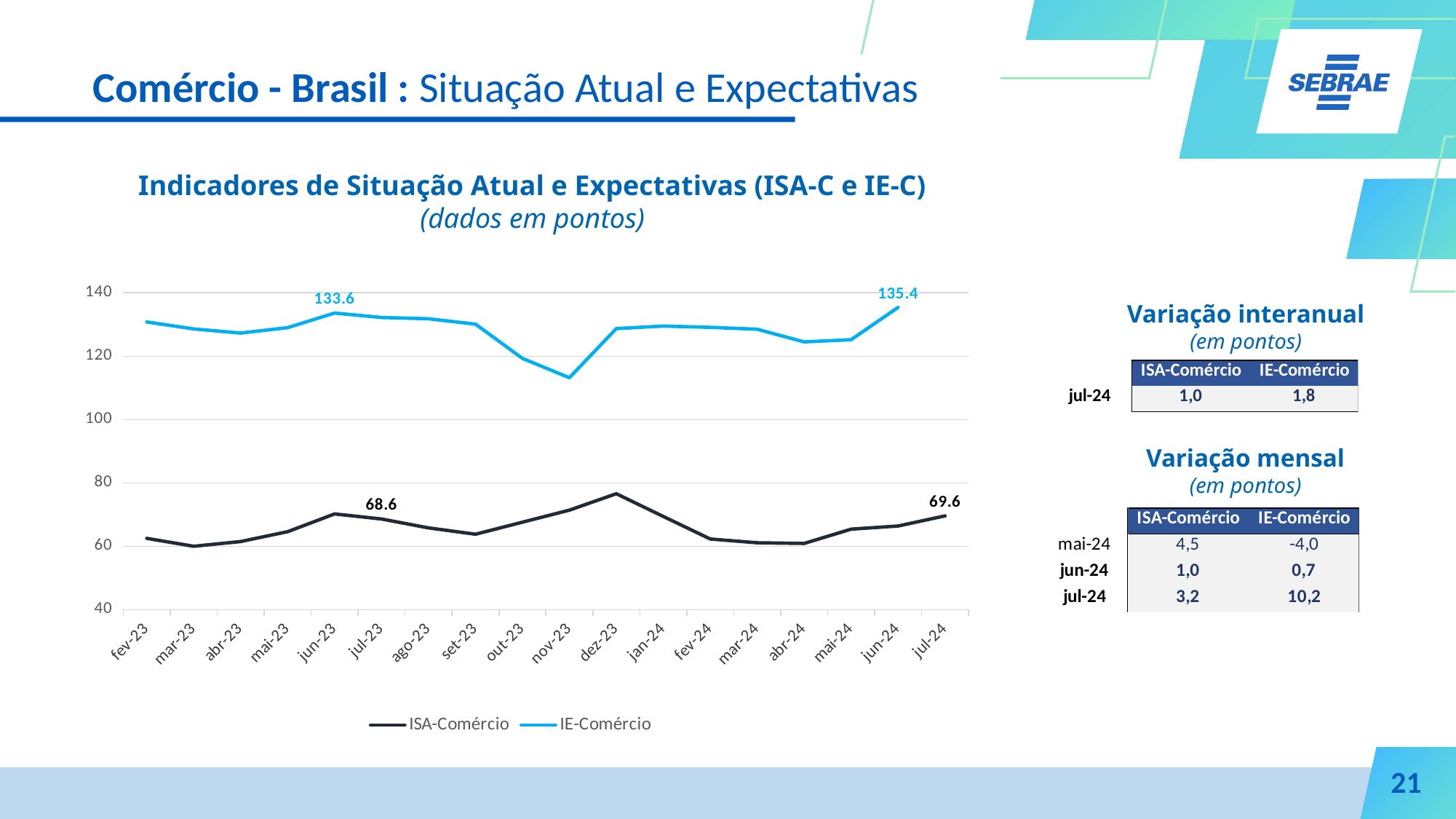
How many series does the chart legend list? 2 What is the title of the chart? Indicadores de Situação Atual e Expectativas (ISA-C e IE-C) What is the value of IE-Comércio in jun-23? 133.6 How many months are shown on the x axis of the chart? 18 Is the value for IE-Comércio in nov-23 greater or less than 120? less What type of chart is shown on the slide? line chart What is the value of ISA-Comércio in jul-24? 69.6